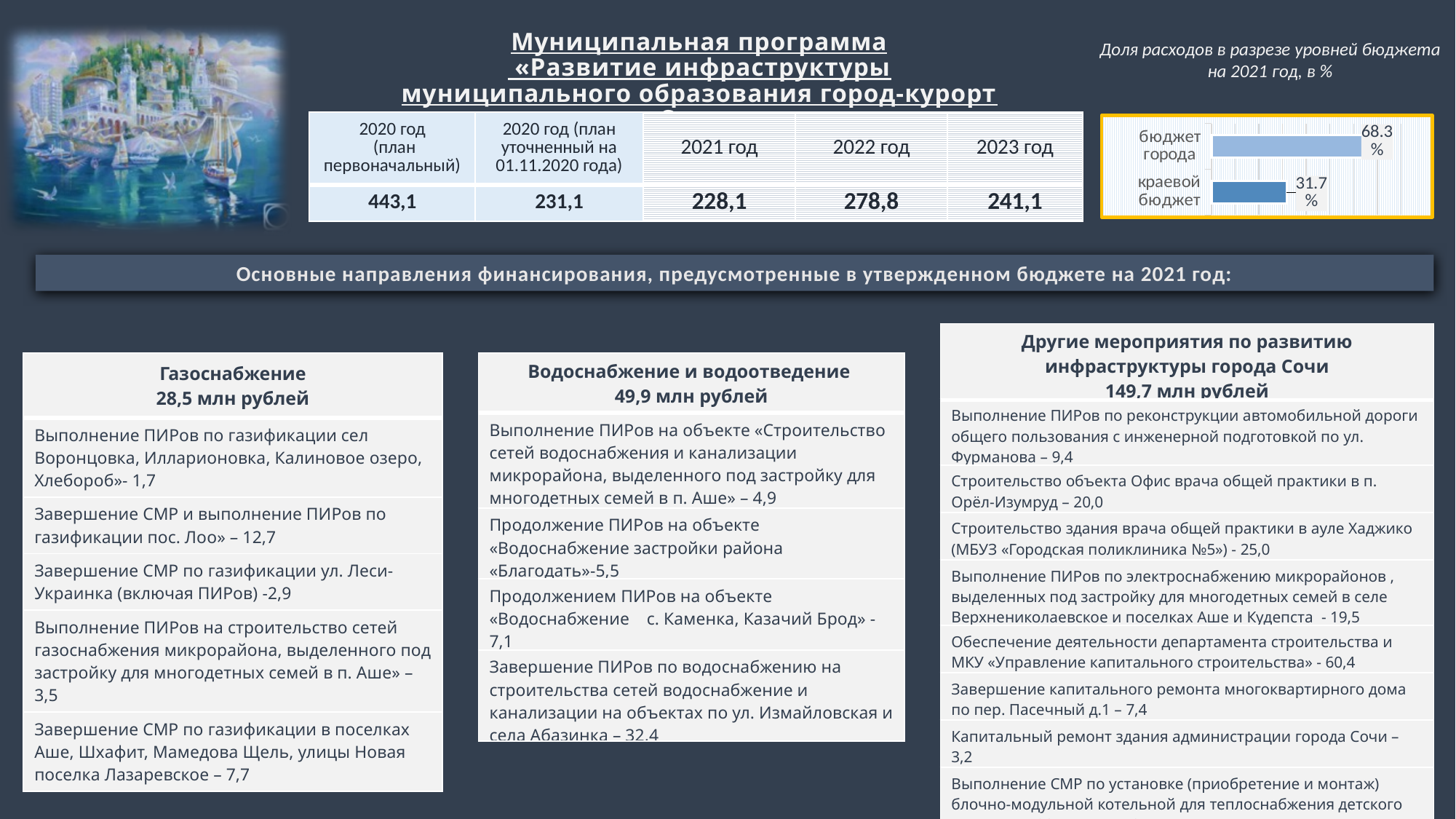
Which is larger, the value for бюджет города or the value for краевой бюджет? бюджет города Which category is listed first (at the top) in the chart? бюджет города What kind of chart is shown on the slide? bar chart Which category has the lowest value in the chart? краевой бюджет What is the difference between the values for бюджет города and краевой бюджет? 36.6% How many categories are shown in the chart? 2 Which category has the highest value in the chart? бюджет города What is the title of the chart on the slide? Доля расходов в разрезе уровней бюджета на 2021 год, в % What is the value for бюджет города in the chart? 68.3% What is the value for краевой бюджет in the chart? 31.7%